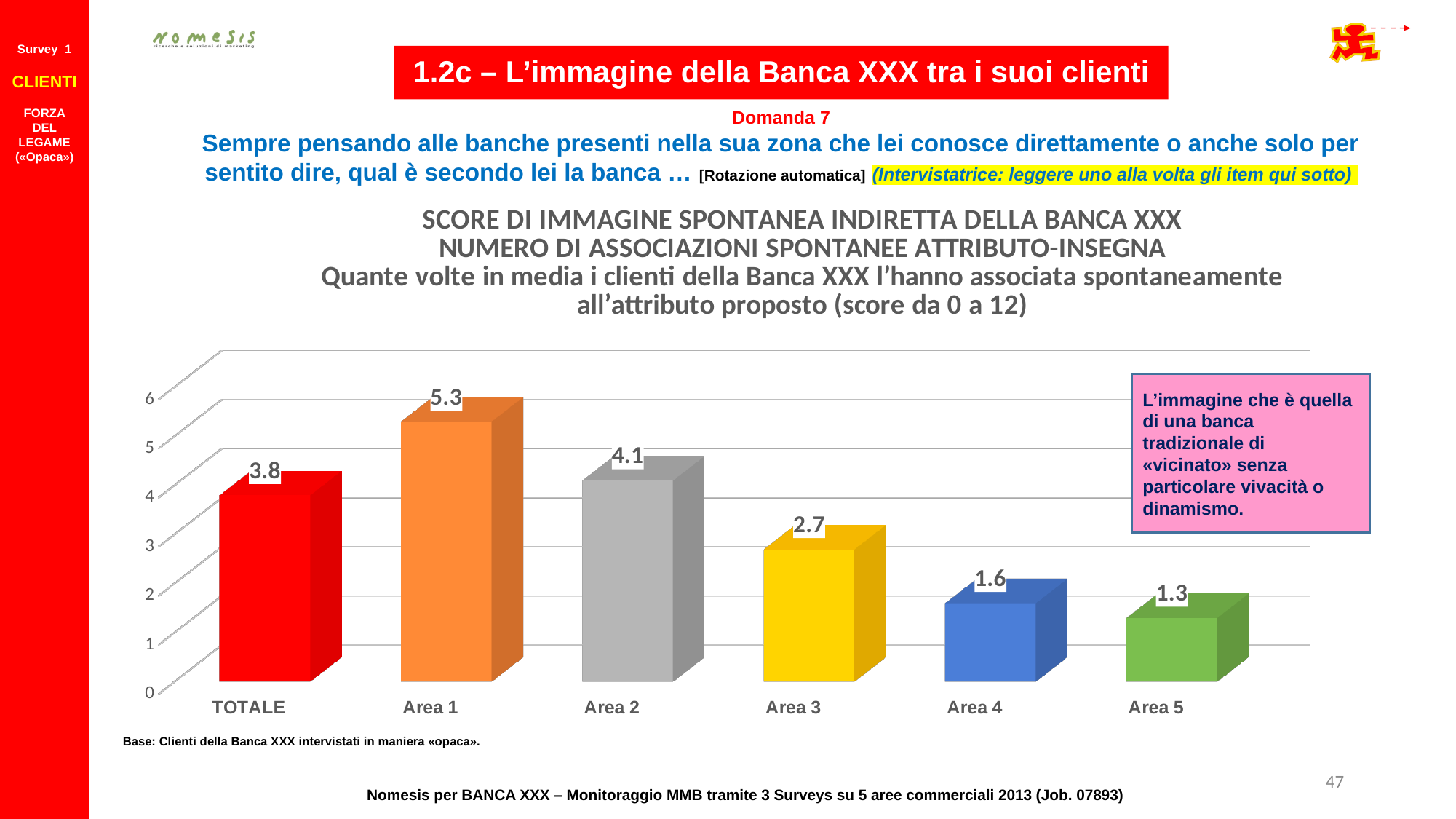
Which area has the highest score? Area 1 Do the values rise or fall from Area 1 to Area 5? fall Which is larger, the value for Area 2 or the value for TOTALE? Area 2 What is the difference between the values for Area 4 and Area 5? 0.3 What is the value for Area 1? 5.3 What is the value for Area 5? 1.3 How many categories are shown on the x axis? 6 What is the value for Area 3? 2.7 What is the value for TOTALE? 3.8 What kind of chart is shown on the slide? bar chart What is the difference between the values for Area 1 and Area 2? 1.2 Which area has the lowest score? Area 5